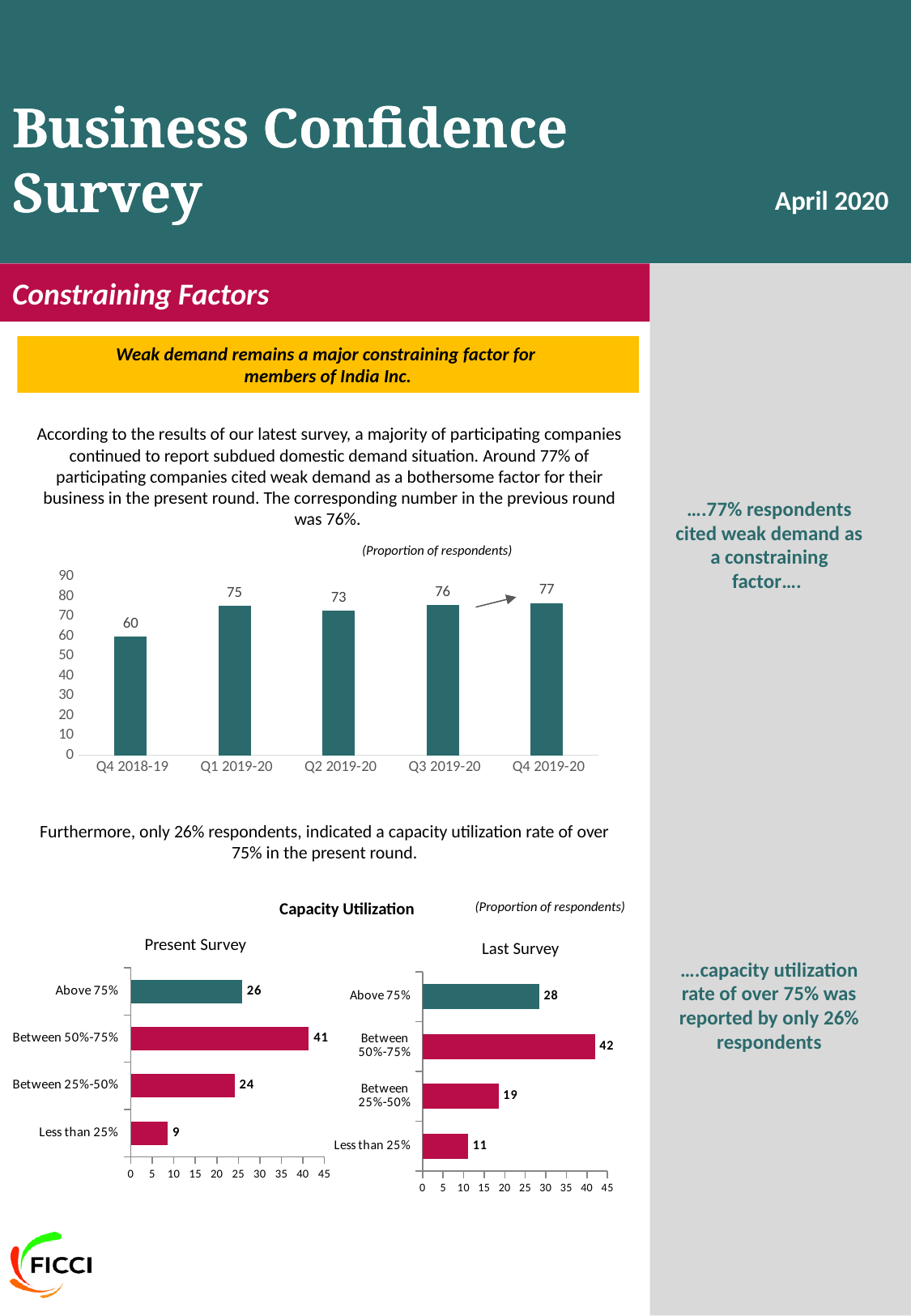
In the top bar chart showing the proportion of respondents citing weak demand, which quarter has the lowest value? Q4 2018-19 In the top bar chart showing the proportion of respondents citing weak demand, what is the value for Q4 2019-20? 77 In the Last Survey capacity utilization chart, which category has the highest value? Between 50%-75% In the top bar chart showing the proportion of respondents citing weak demand, what is the difference between Q1 2019-20 and Q4 2018-19? 15 In the Present Survey capacity utilization chart, what is the value for Between 50%-75%? 41 In the Present Survey capacity utilization chart, which category has the lowest value? Less than 25% What kind of chart is the Present Survey capacity utilization chart? bar chart How many quarters are plotted in the top bar chart showing the proportion of respondents citing weak demand? 5 In the Last Survey capacity utilization chart, what is the value for Above 75%? 28 What is the difference between the Less than 25% values in the Last Survey chart and the Present Survey chart? 2 How many categories are shown in the Last Survey capacity utilization chart? 4 In the top bar chart showing the proportion of respondents citing weak demand, is the value for Q2 2019-20 greater or less than Q3 2019-20? less